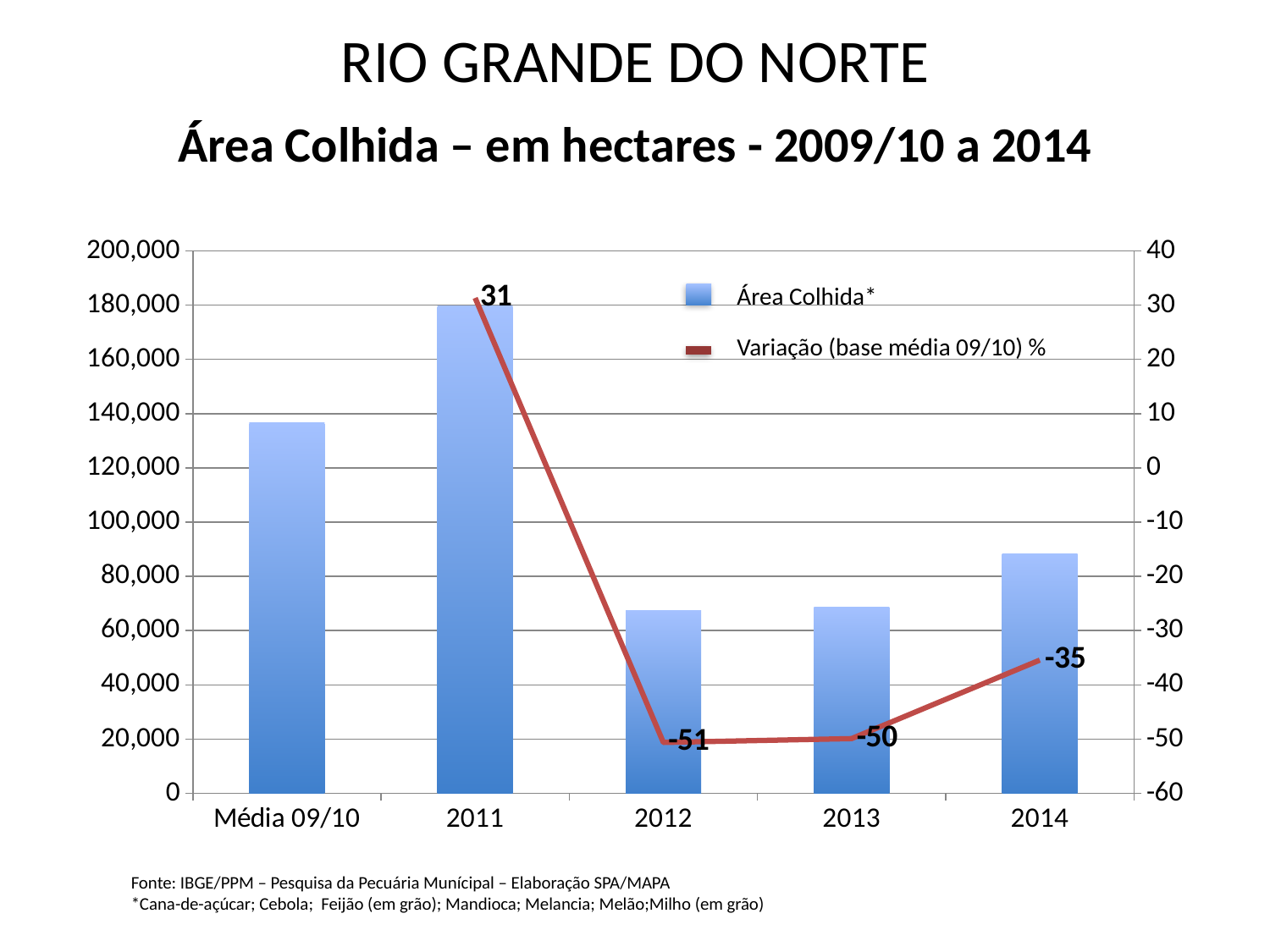
What is the value of Variação (base média 09/10) % for 2012? -51 How many series does the legend list? 2 How many categories are shown on the x axis? 5 Which year has the highest Variação (base média 09/10) %? 2011 Is the Área Colhida value for 2011 greater or less than 160,000? greater Which category has the tallest Área Colhida bar? 2011 Is the Área Colhida value for 2012 greater or less than 80,000? less Which year has the lowest Variação (base média 09/10) %? 2012 Which year has the larger Variação value, 2013 or 2012? 2013 What is the value of Variação (base média 09/10) % for 2014? -35 What is the value of Variação (base média 09/10) % for 2011? 31 What is the difference between the Variação values for 2011 and 2014? 66